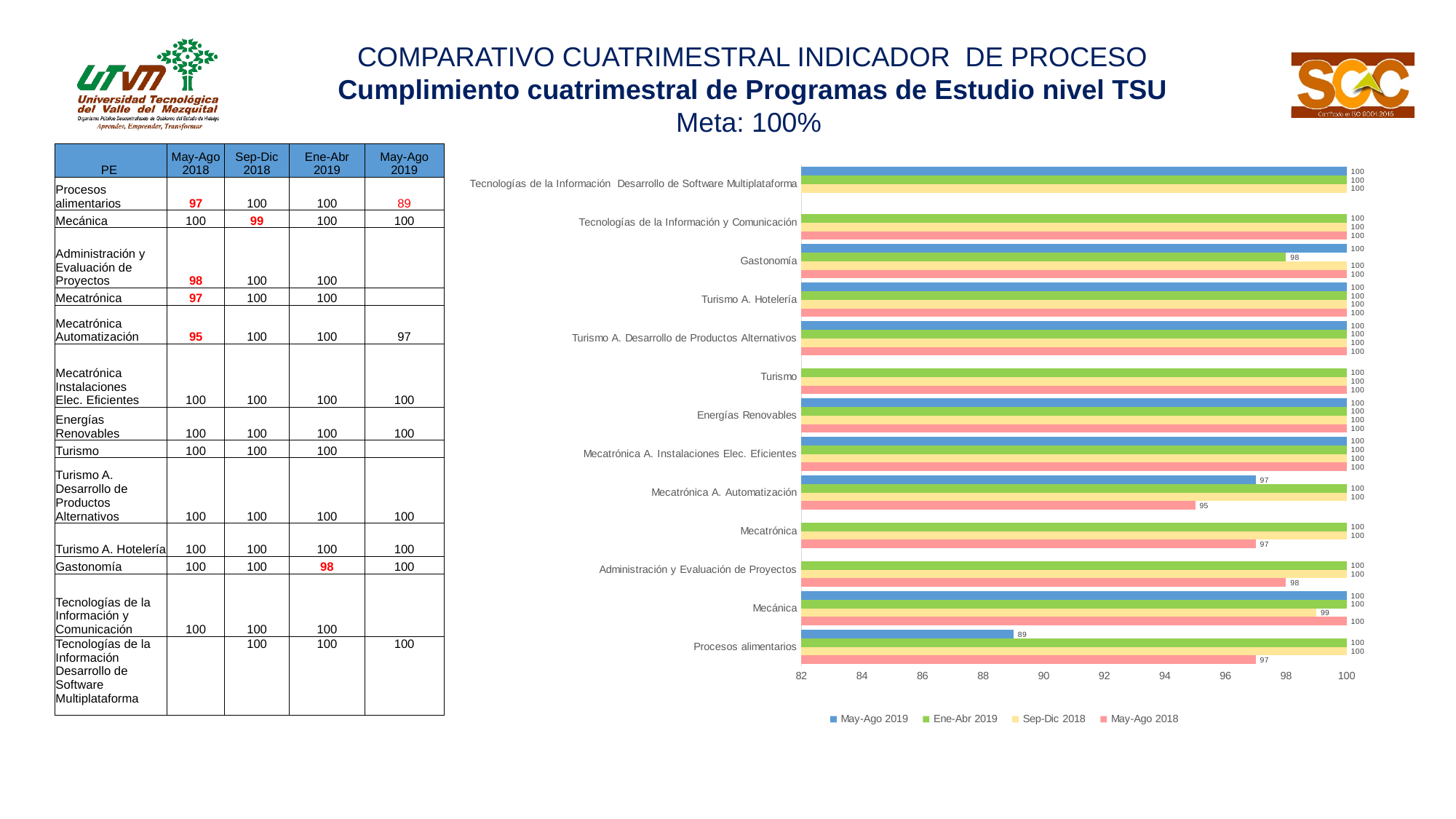
What is the target (Meta) stated in the chart's title area? 100% What is the difference between the May-Ago 2018 value (97) and the May-Ago 2019 value (89) for Procesos alimentarios? 8 How many series does the chart legend list? 4 How many programs (categories) are plotted in the chart? 13 What is the Ene-Abr 2019 value for Gastronomía in the chart? 98 For Mecatrónica A. Automatización, which is larger: the May-Ago 2019 value or the May-Ago 2018 value? May-Ago 2019 What is the Sep-Dic 2018 value for Mecánica in the chart? 99 What is the May-Ago 2018 value for Mecatrónica A. Automatización in the chart? 95 What is the May-Ago 2019 value for Procesos alimentarios in the chart? 89 Which program has the lowest May-Ago 2019 value in the chart? Procesos alimentarios Is the May-Ago 2019 value for Procesos alimentarios greater or less than 90? less What type of chart is shown on the slide? bar chart